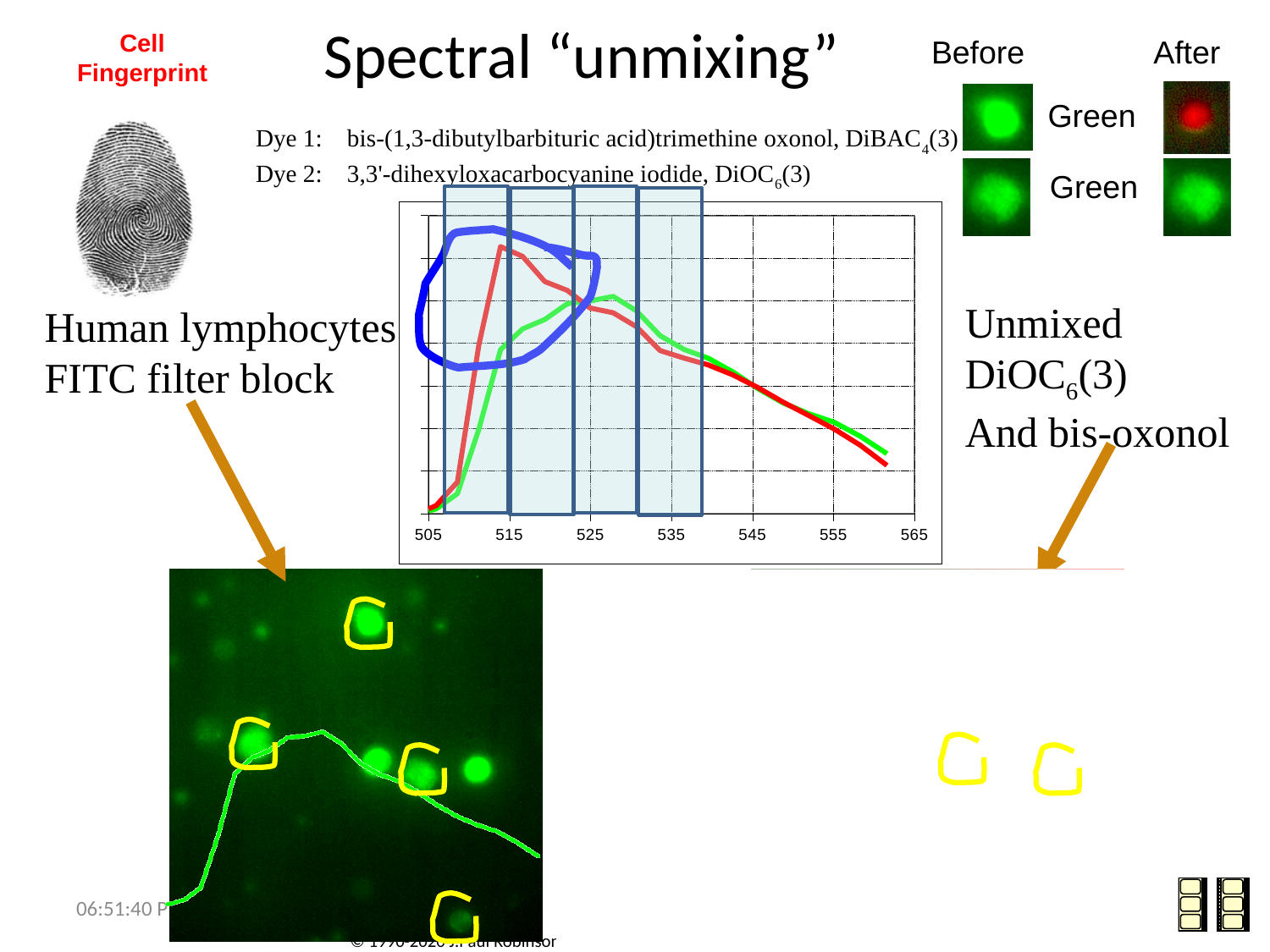
At x = 530, which line is higher, the red line or the green line? green How many shaded vertical bands are overlaid on the chart? 4 Is the x value at which the green line peaks greater or less than 515? greater At x = 515, which line is higher, the red line or the green line? red What colours are the two lines plotted on the chart? red and green Do the two lines rise or fall as x increases from 545 to 565? fall What is the lowest value labelled on the x axis of the chart? 505 Which line reaches its peak at a lower x value, the red line or the green line? red How many tick labels are shown on the x axis of the chart? 7 How many lines (series) are plotted on the chart? 2 What is the highest value labelled on the x axis of the chart? 565 What kind of chart is shown in the centre of the slide? line chart